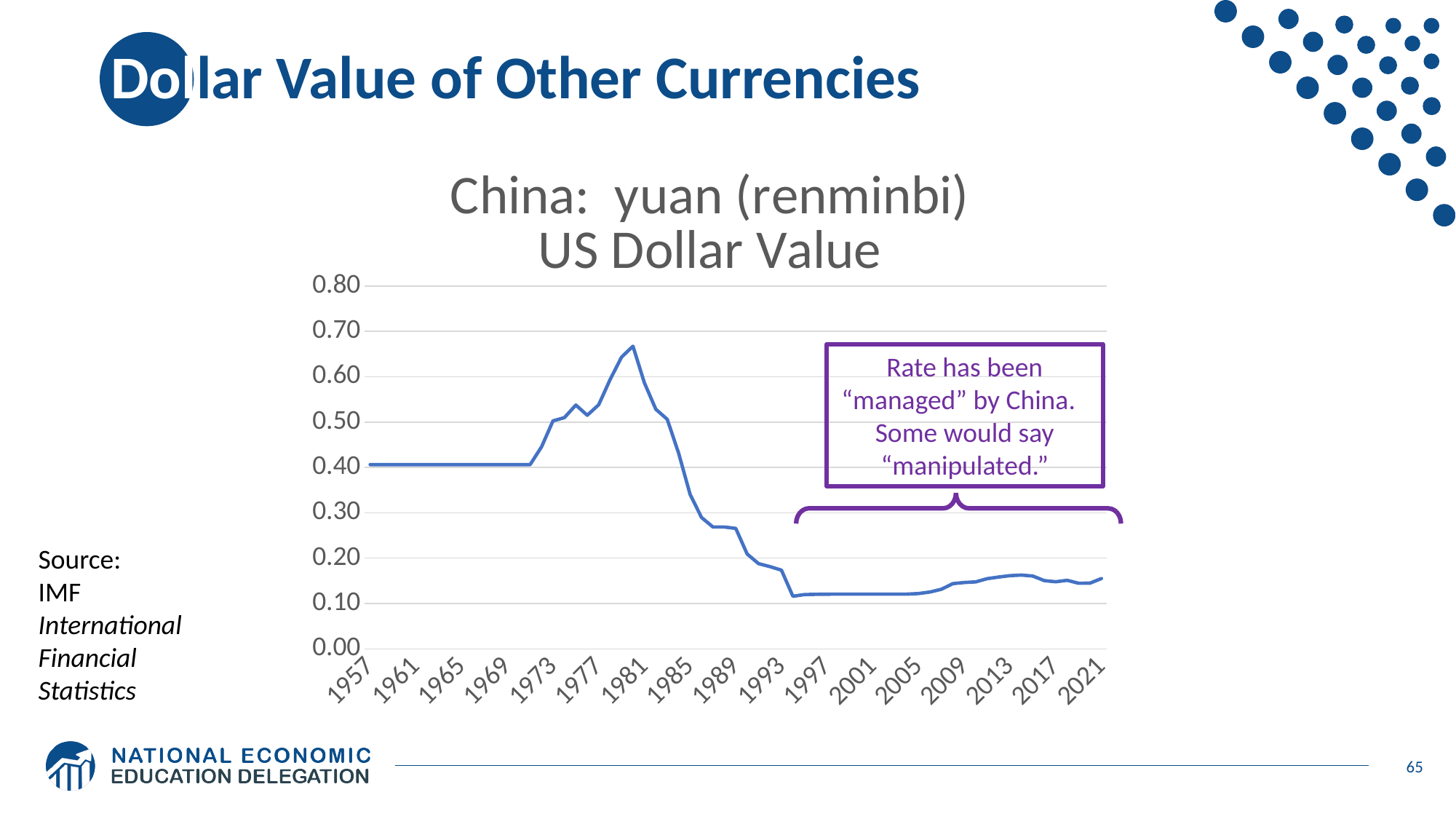
Is the value for 2021 greater or less than 0.30? less In which year does the US dollar value of the yuan reach its highest point? 1980 What is the highest value shown on the y axis? 0.80 Is the value for 1997 greater or less than 0.20? less How many year labels are shown on the x axis? 17 What kind of chart is shown on the slide? line chart Is the value for 1957 greater or less than 0.30? greater Do the values rise or fall between 1981 and 1993? fall What is the title of the chart? China: yuan (renminbi) US Dollar Value Which year has the larger value, 1973 or 2013? 1973